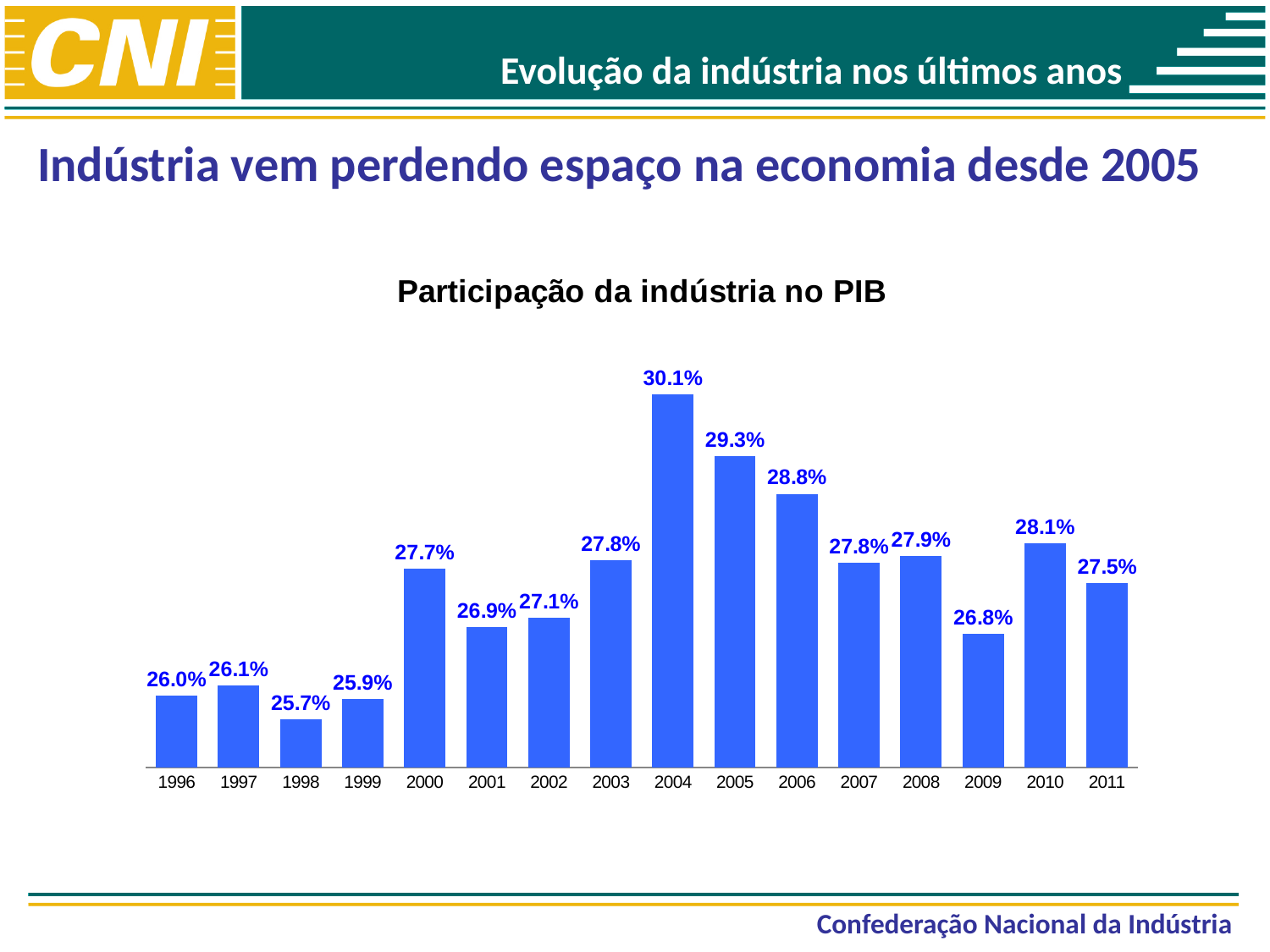
What is the value for 2011? 27.5% What is the difference between the values for 2004 and 2005? 0.8% What is the value for 1998? 25.7% What is the difference between the values for 2010 and 2009? 1.3% Which year has the highest value? 2004 What is the value for 2009? 26.8% What is the title of the chart? Participação da indústria no PIB What is the value for 2004? 30.1% How many years are shown on the x axis? 16 Which year has the lowest value? 1998 Which is larger, the value for 2000 or the value for 2001? 2000 What kind of chart is this? bar chart